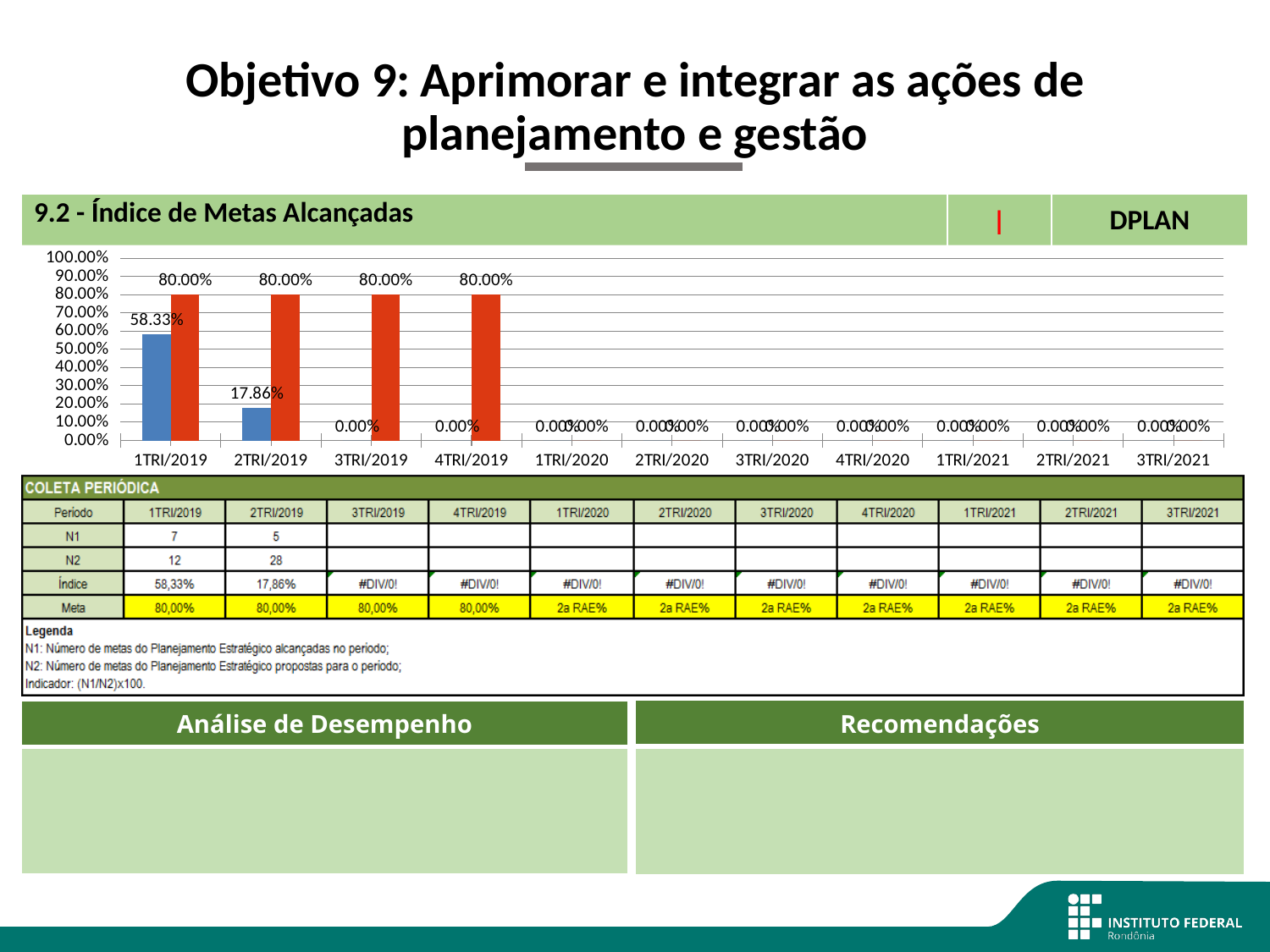
What is the difference between the blue bar values for 1TRI/2019 and 2TRI/2019? 40.47% What is the value of the red bar for 1TRI/2019? 80.00% Do the blue bars rise or fall from 1TRI/2019 to 3TRI/2019? fall What is the value of the blue bar for 1TRI/2019? 58.33% What is the value of the blue bar for 3TRI/2019? 0.00% What kind of chart is shown on the slide? bar chart Which is larger, the blue bar for 1TRI/2019 or the blue bar for 2TRI/2019? 1TRI/2019 How many categories are shown on the x axis of the chart? 11 Is the blue bar for 1TRI/2019 greater or less than 50.00%? greater For 1TRI/2019, what is the difference between the red bar and the blue bar? 21.67% What is the value of the blue bar for 2TRI/2019? 17.86% Which category has the highest blue bar? 1TRI/2019